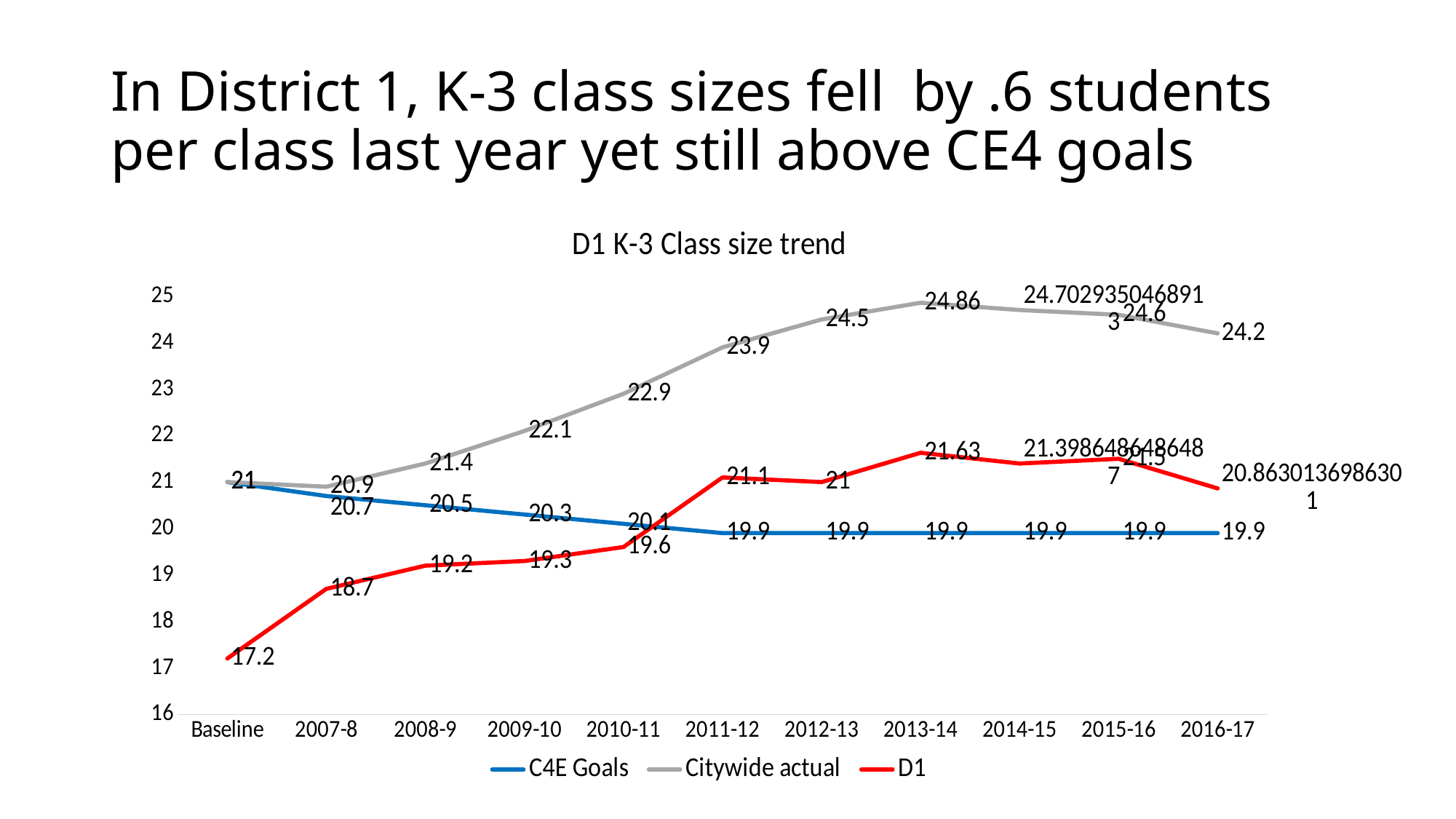
Does the C4E Goals series rise or fall from Baseline to 2016-17? Fall What is the Citywide actual value for 2013-14? 24.86 In which category is the D1 series at its lowest value? Baseline In which year does the Citywide actual series reach its highest value? 2013-14 How many series does the legend list? 3 What is the D1 value for 2008-9? 19.2 What is the D1 value at Baseline? 17.2 How many categories are shown on the x axis? 11 What is the C4E Goals value for 2016-17? 19.9 What type of chart is shown on the slide? Line chart In 2011-12, which is larger: the D1 value or the C4E Goals value? D1 What is the difference between the Citywide actual value and the C4E Goals value in 2016-17? 4.3